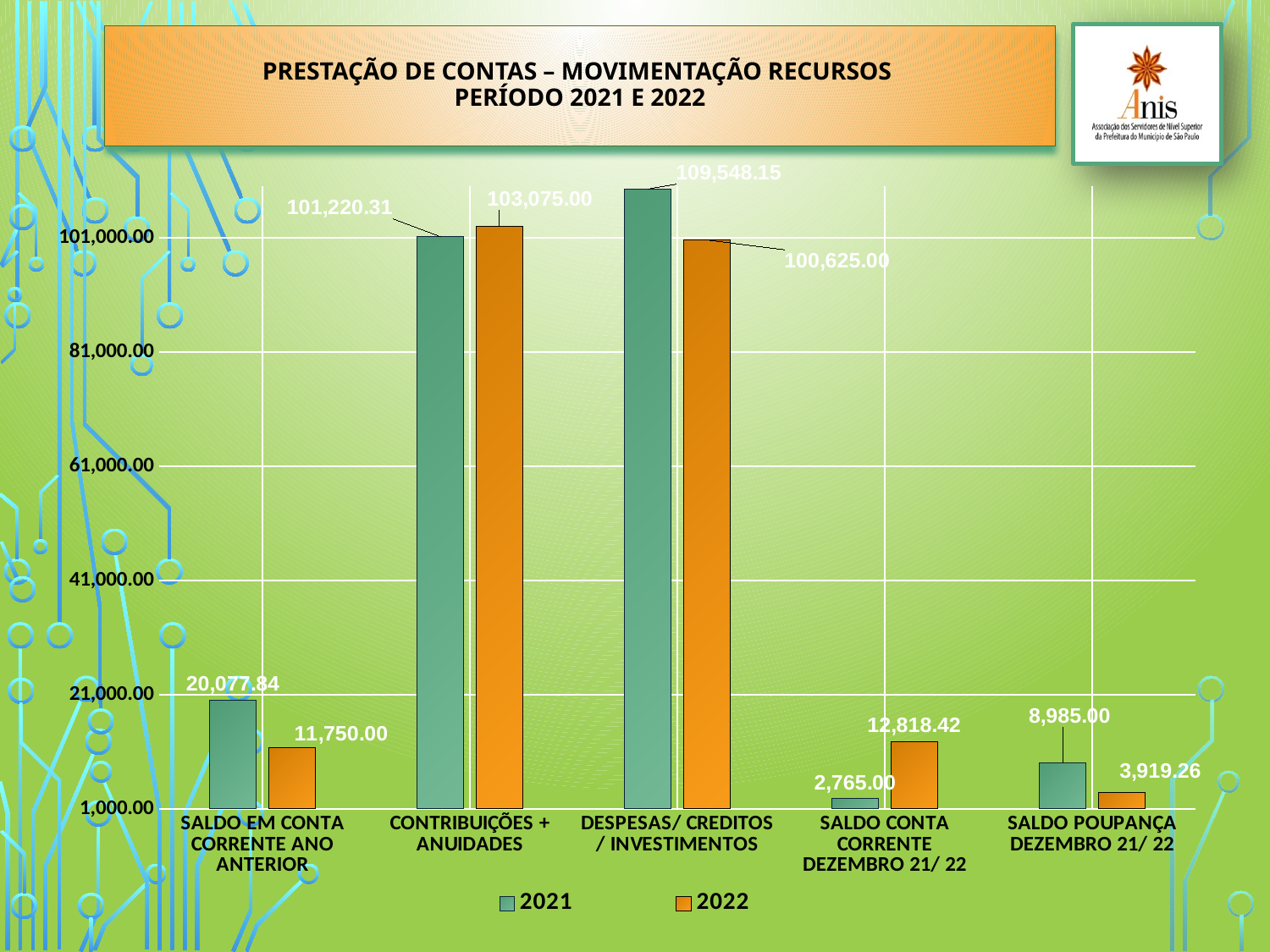
What is the 2022 value for SALDO POUPANÇA DEZEMBRO 21/ 22? 3,919.26 What is the difference between the 2021 and 2022 values for SALDO EM CONTA CORRENTE ANO ANTERIOR? 8,327.84 What kind of chart is shown on the slide? Bar chart Which category has the highest 2021 value? DESPESAS/ CREDITOS / INVESTIMENTOS What is the 2021 value for SALDO EM CONTA CORRENTE ANO ANTERIOR? 20,077.84 What is the difference between the 2022 and 2021 values for SALDO CONTA CORRENTE DEZEMBRO 21/ 22? 10,053.42 Which category has the lowest 2021 value? SALDO CONTA CORRENTE DEZEMBRO 21/ 22 How many series does the legend list? 2 How many categories are shown on the x axis? 5 What is the 2021 value for DESPESAS/ CREDITOS / INVESTIMENTOS? 109,548.15 What is the 2022 value for CONTRIBUIÇÕES + ANUIDADES? 103,075.00 For DESPESAS/ CREDITOS / INVESTIMENTOS, which year has the larger value, 2021 or 2022? 2021